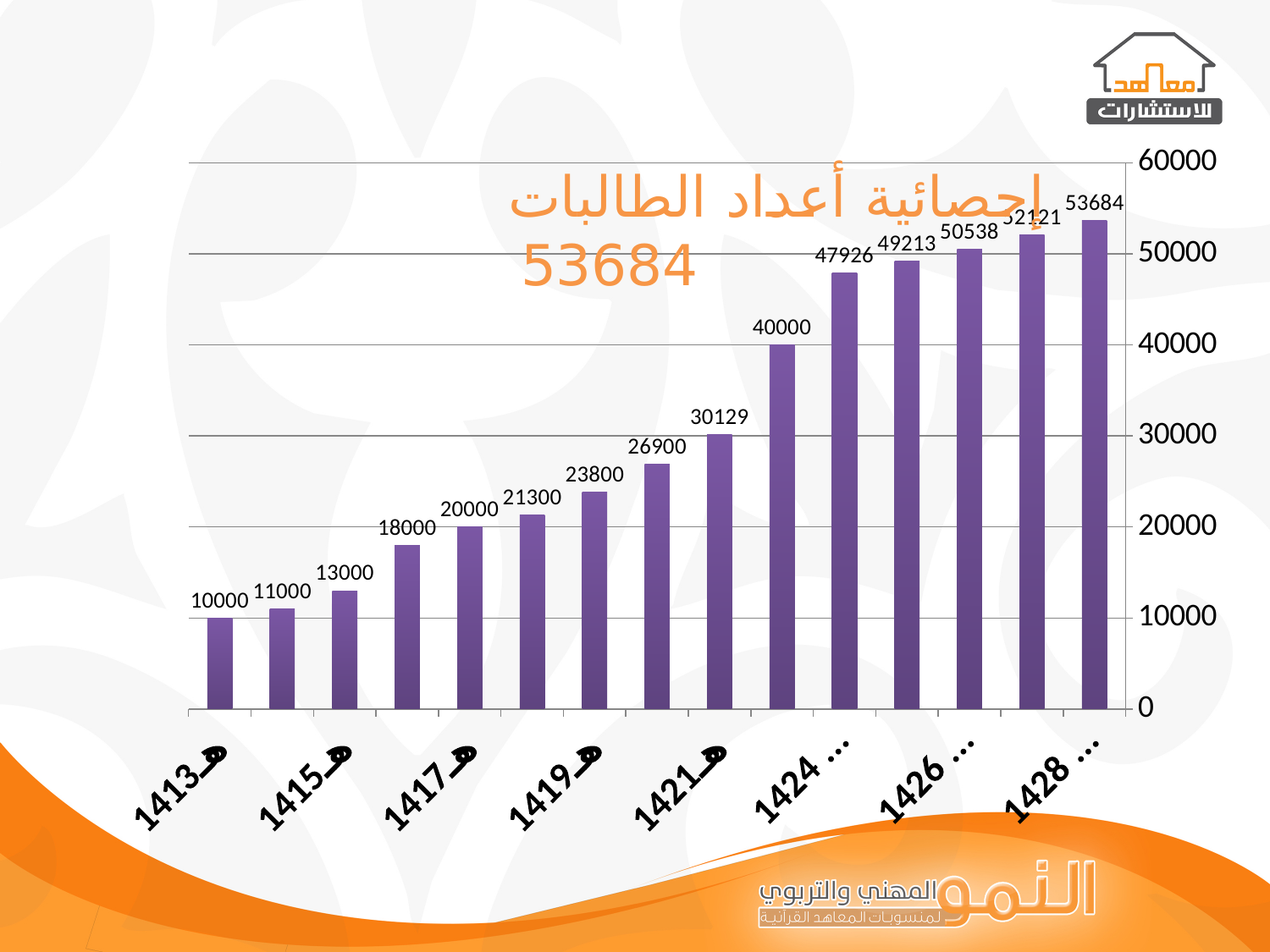
What is the value for 1421هـ? 30129 How many bars are plotted in the chart? 15 Which category has the highest value? 1428 Is the value for 1424 greater or less than 40000? greater What is the difference between the values for 1428 and 1413هـ? 43684 What is the value for 1417هـ? 20000 Do the values rise or fall from left to right along the x axis? rise What is the value for the last bar, labelled 1428? 53684 Which category has the lowest value? 1413هـ Which is larger, the value for 1417هـ or the value for 1419هـ? 1419هـ What type of chart is shown on the slide? bar chart What is the value for 1413هـ? 10000